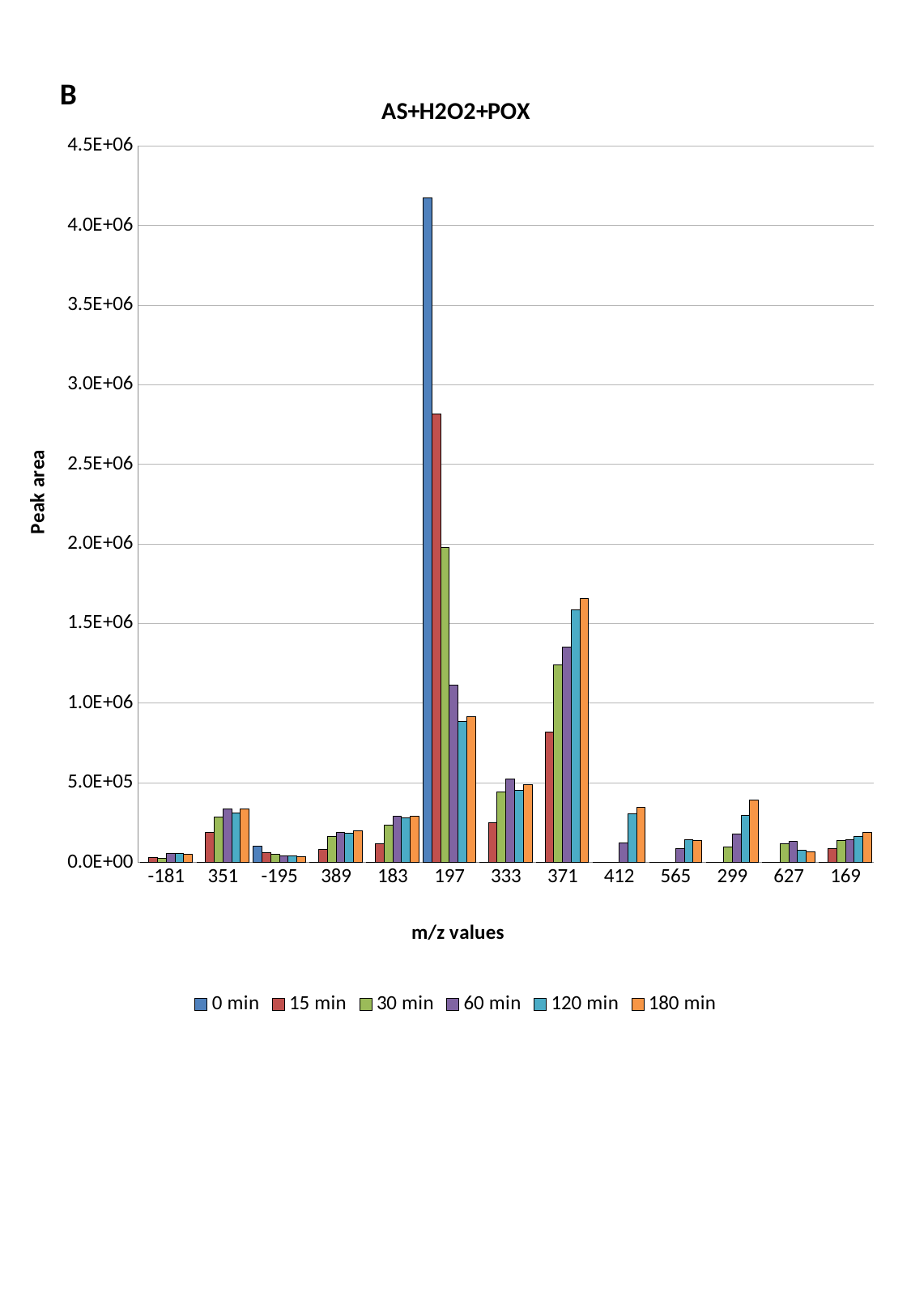
Is the 180 min value for m/z 371 greater or less than 1.5E+06? greater Which is larger: the 15 min value at m/z 197 or the 30 min value at m/z 197? 15 min at m/z 197 Is the 0 min value for m/z 197 greater or less than 4.0E+06? greater How many series does the legend list? 6 Is the 15 min value for m/z 197 greater or less than 3.0E+06? less Which series has the highest peak area at m/z 371? 180 min What is the title of the chart? AS+H2O2+POX What kind of chart is shown on the slide? bar chart How many m/z value categories are shown on the x axis? 13 What is the label of the y axis? Peak area Which m/z value has the highest 0 min peak area? 197